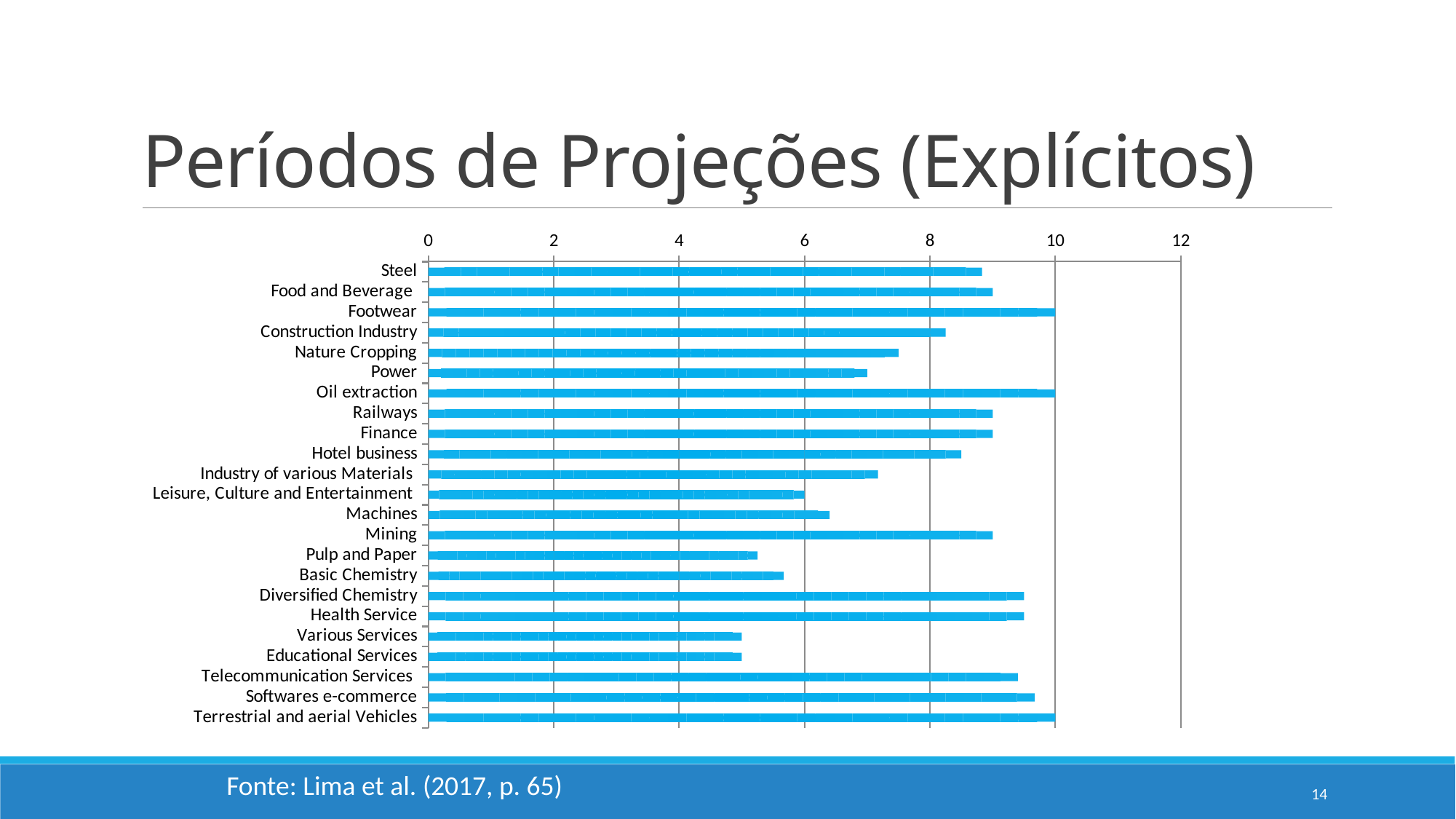
Is the value for Power greater or less than 8? less Is the value for Steel greater or less than 8? greater Which is larger, the value for Footwear or the value for Construction Industry? Footwear What is the value for Oil extraction? 10 What is the value for Footwear? 10 What kind of chart is shown on the slide? Bar chart What is the title of the slide containing the chart? Períodos de Projeções (Explícitos) Which is larger, the value for Mining or the value for Machines? Mining What is the value for Terrestrial and aerial Vehicles? 10 How many categories (industries) are plotted in the chart? 23 Is the value for Diversified Chemistry greater or less than 10? less